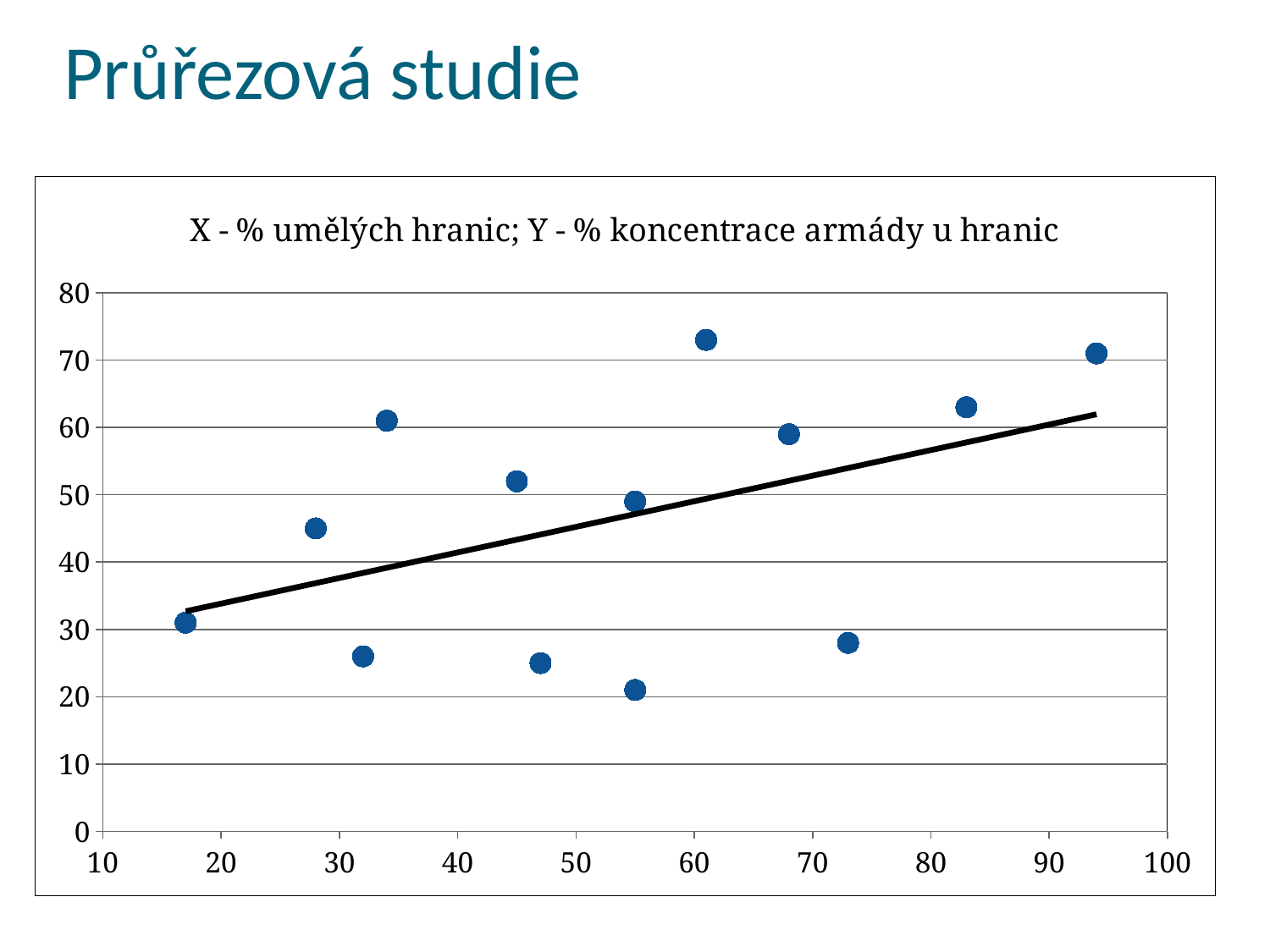
Does the trend line on the chart rise or fall as the x value increases? rises How many data points are plotted on the chart? 13 Is the y value of the point with the smallest x value (near x = 17) greater or less than 40? less What is the title of the chart? X - % umělých hranic; Y - % koncentrace armády u hranic Is the y value of the point with the largest x value (near x = 94) greater or less than 60? greater Is the y value of the lowest plotted point greater or less than 30? less What kind of chart is shown on the slide? scatter chart Which has the higher y value: the point near x = 61 or the point near x = 68? the point near x = 61 What is the highest value shown on the y axis of the chart? 80